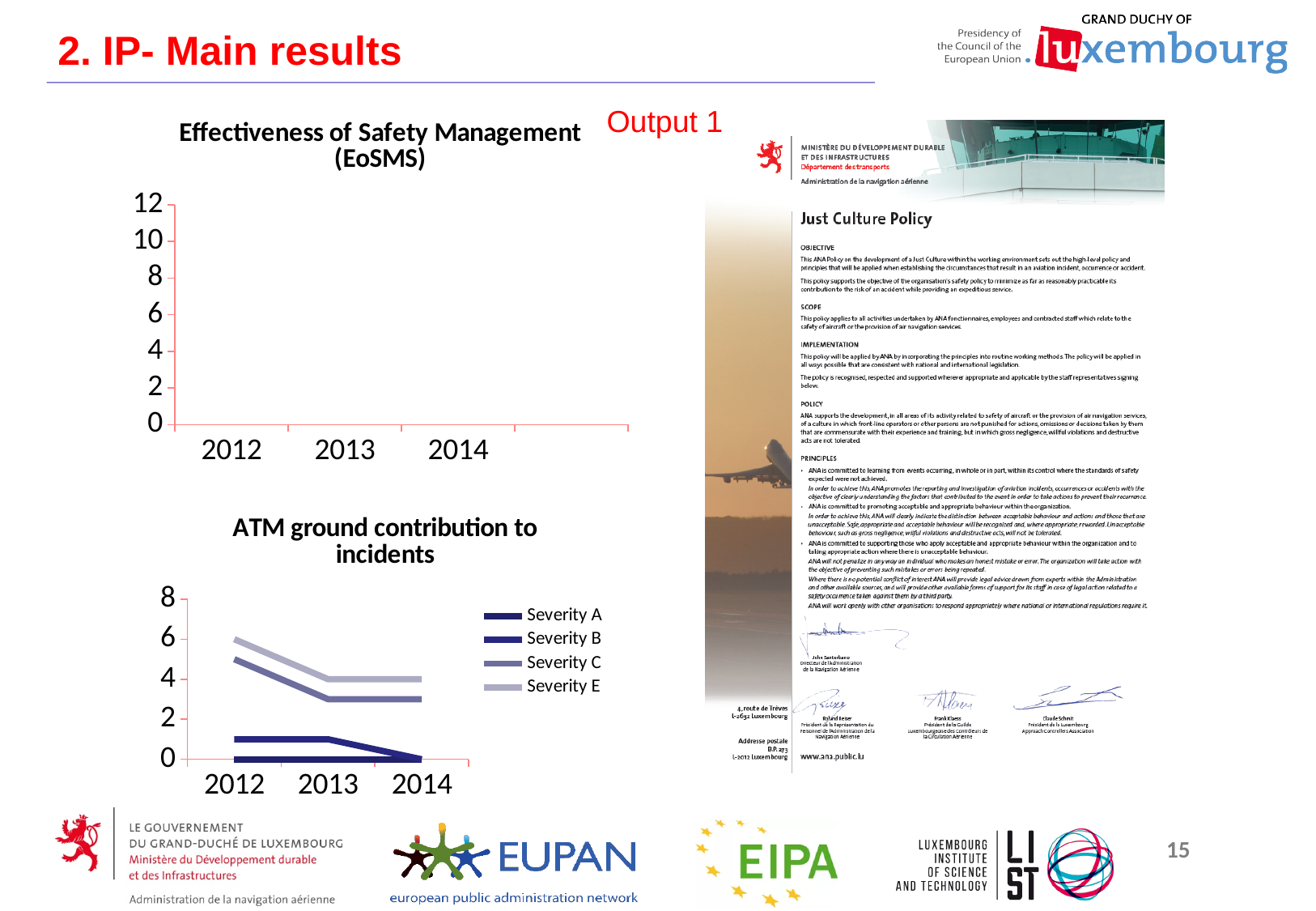
What kind of chart is the 'ATM ground contribution to incidents' chart? line chart In the 'ATM ground contribution to incidents' chart, what is the value for Severity E in 2012? 6 In the 'ATM ground contribution to incidents' chart, which series has the highest value in 2013? Severity E How many series does the legend of the 'ATM ground contribution to incidents' chart list? 4 How many years are shown on the x axis of the 'Effectiveness of Safety Management (EoSMS)' chart? 3 In the 'ATM ground contribution to incidents' chart, is the value for Severity C in 2012 greater or less than 4? greater What is the title of the upper chart on the slide? Effectiveness of Safety Management (EoSMS) In the 'ATM ground contribution to incidents' chart, which is larger in 2012: Severity E or Severity C? Severity E How many years are shown on the x axis of the 'ATM ground contribution to incidents' chart? 3 In the 'ATM ground contribution to incidents' chart, does the Severity E line rise or fall from 2012 to 2014? fall In the 'ATM ground contribution to incidents' chart, is the value for Severity B in 2012 greater or less than 2? less In the 'ATM ground contribution to incidents' chart, what is the value for Severity E in 2014? 4